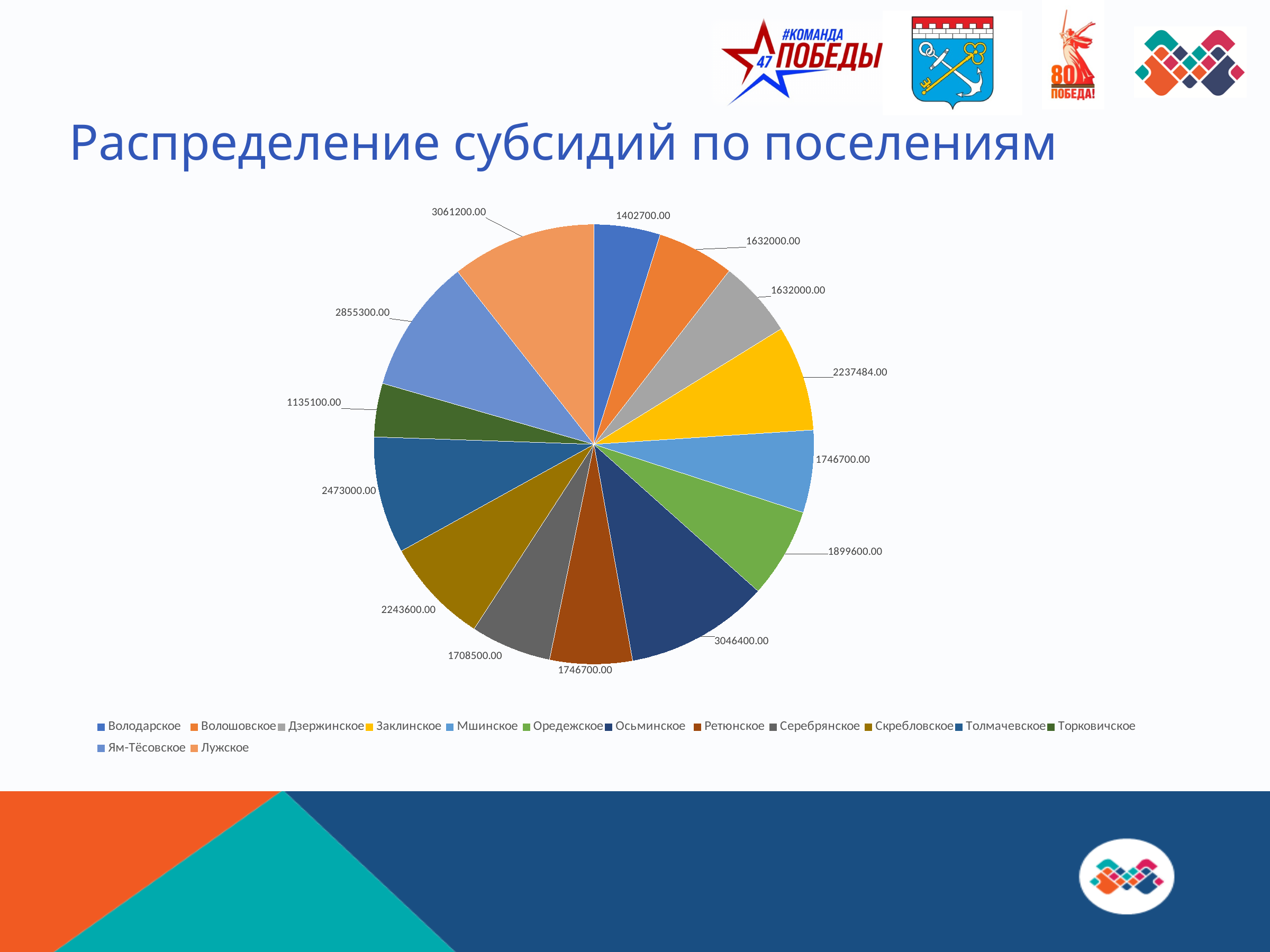
What is the difference between the values for Осьминское and Оредежское? 1146800.00 How many slices (settlements) does the pie chart have? 14 What is the difference between the values for Лужское and Торковичское? 1926100.00 Which settlement has the largest subsidy? Лужское Which is larger, the value for Ям-Тёсовское or for Толмачевское? Ям-Тёсовское What is the value for Володарское? 1402700.00 What kind of chart is shown on the slide? pie chart Which settlement has the smallest subsidy? Торковичское What is the value for Ям-Тёсовское? 2855300.00 What is the chart's title? Распределение субсидий по поселениям What is the value for Заклинское? 2237484.00 What is the value for Осьминское? 3046400.00